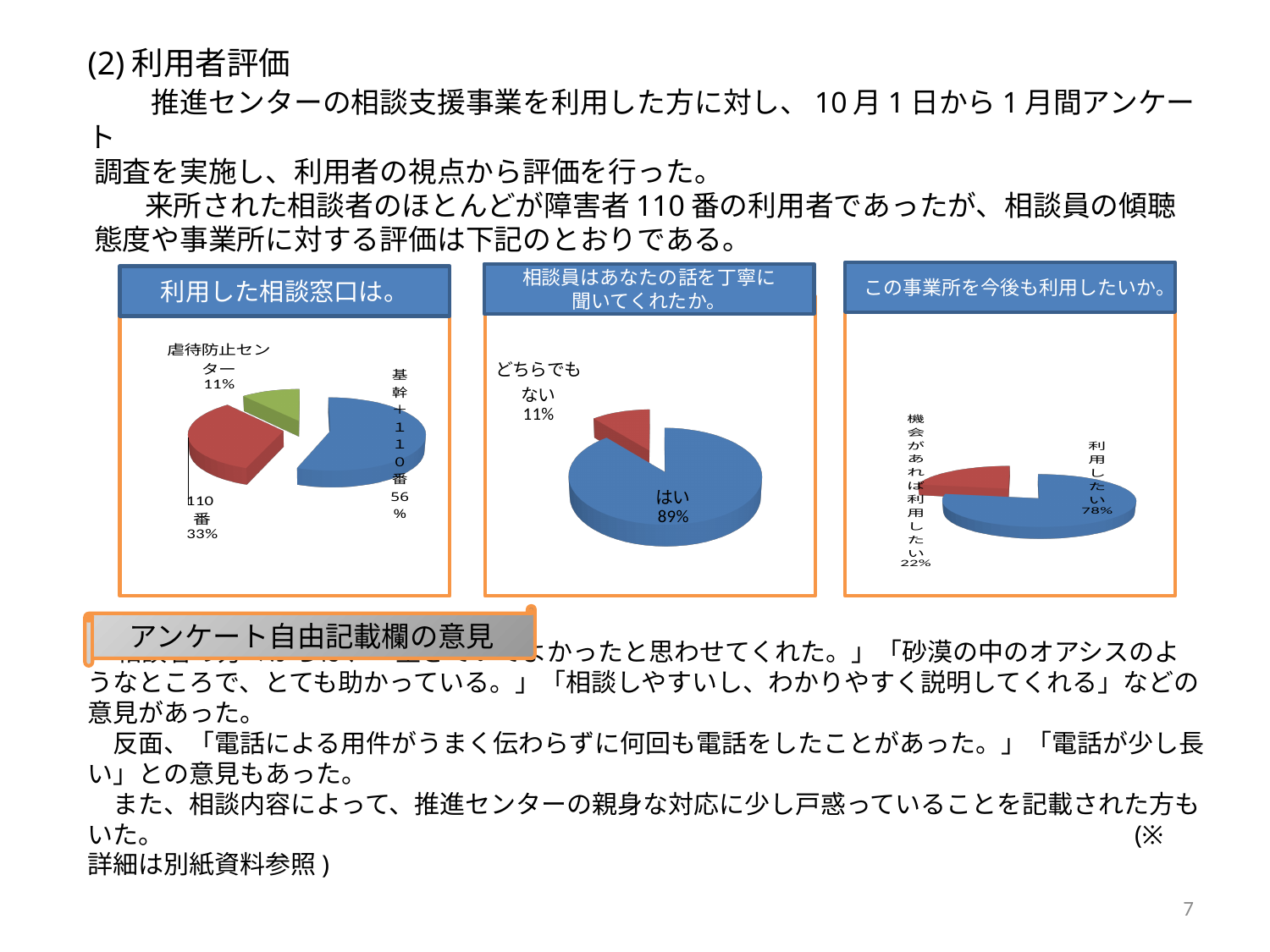
「相談員はあなたの話を丁寧に聞いてくれたか。」のグラフはどの種類のグラフですか。 円グラフ 「利用した相談窓口は。」のグラフで、最も割合が小さい区分はどれですか。 虐待防止センター 「相談員はあなたの話を丁寧に聞いてくれたか。」のグラフで、「どちらでもない」の割合はいくつですか。 11% 「利用した相談窓口は。」のグラフには区分がいくつありますか。 3 「利用した相談窓口は。」のグラフで、「虐待防止センター」の割合はいくつですか。 11% 「この事業所を今後も利用したいか。」のグラフで、「機会があれば利用したい」の割合はいくつですか。 22% 「この事業所を今後も利用したいか。」のグラフで、「利用したい」の割合はいくつですか。 78% 「利用した相談窓口は。」のグラフで、「基幹＋110番」と「110番」の割合の差はいくつですか。 23% 「相談員はあなたの話を丁寧に聞いてくれたか。」のグラフで、「はい」の割合はいくつですか。 89% 「利用した相談窓口は。」のグラフで、「基幹＋110番」の割合はいくつですか。 56% 「利用した相談窓口は。」のグラフで、最も割合が大きい区分はどれですか。 基幹＋110番 「この事業所を今後も利用したいか。」のグラフで、「利用したい」と「機会があれば利用したい」ではどちらの割合が大きいですか。 利用したい